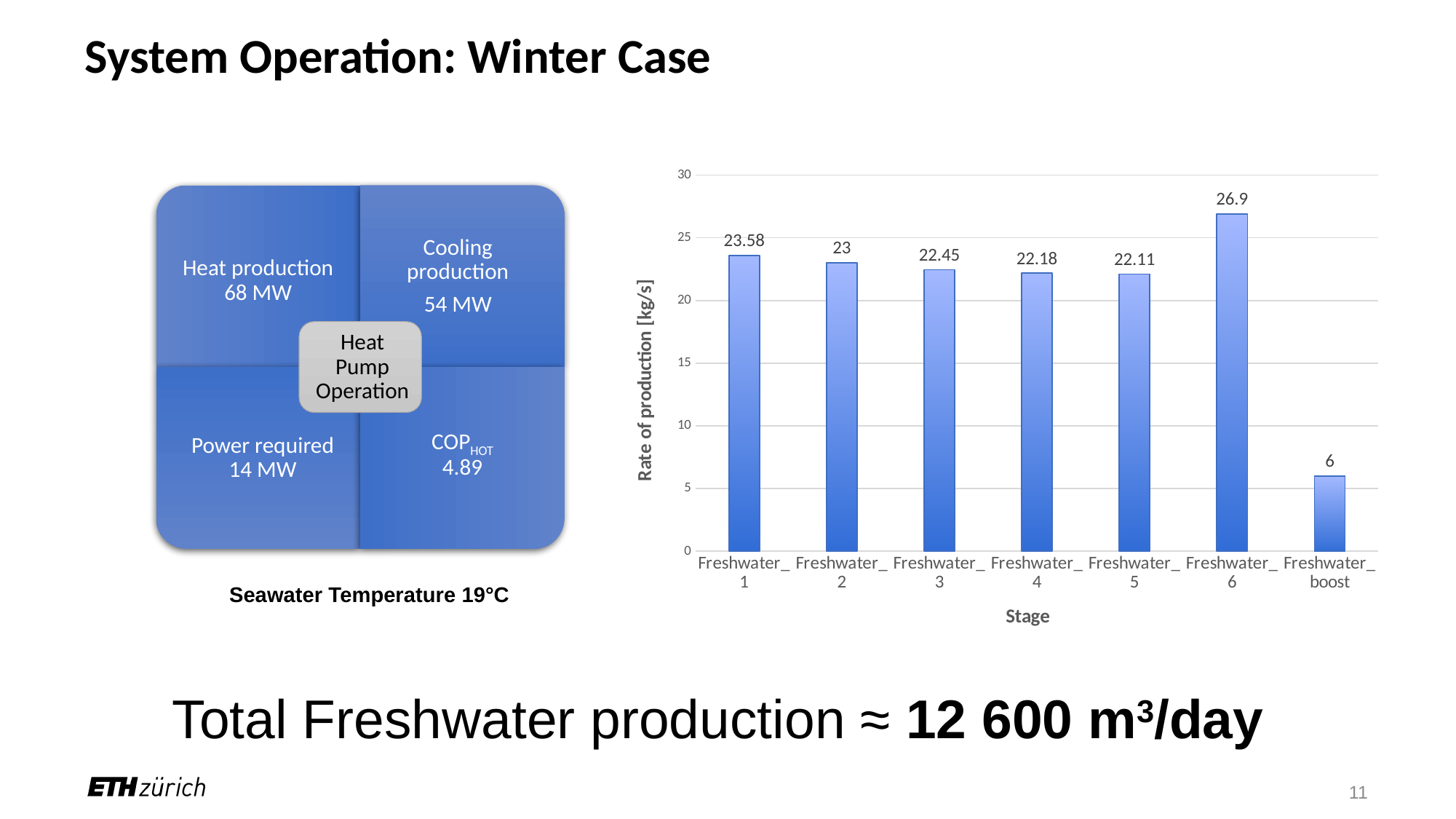
Which has a higher rate of production, Freshwater_3 or Freshwater_5? Freshwater_3 What kind of chart is shown on the slide? bar chart Is the value for Freshwater_6 greater or less than 25? greater What is the difference in rate of production between Freshwater_1 and Freshwater_2? 0.58 Which stage has the lowest rate of production? Freshwater_boost What is the rate of production for Freshwater_4? 22.18 What is the rate of production for Freshwater_boost? 6 What is the label of the y axis of the chart? Rate of production [kg/s] Which stage has the highest rate of production? Freshwater_6 What is the difference in rate of production between Freshwater_6 and Freshwater_boost? 20.9 How many stages are shown on the x axis of the chart? 7 What is the rate of production for Freshwater_1? 23.58